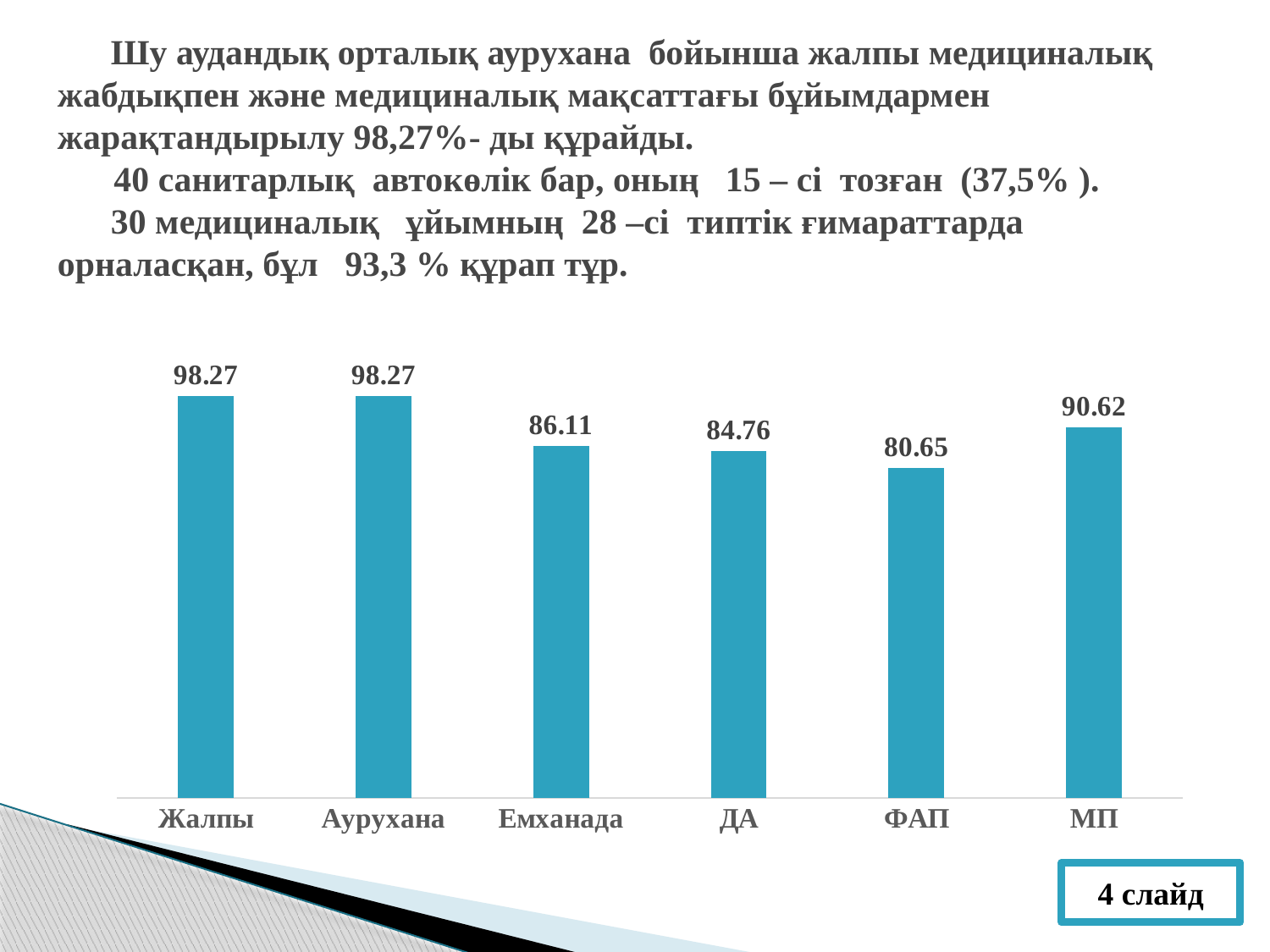
What is the difference between the values for Жалпы and ФАП? 17.62 Which category has the lowest value? ФАП Which is larger, the value for МП or the value for ФАП? МП What is the difference between the values for МП and ДА? 5.86 What is the value for ДА? 84.76 What is the value for Емханада? 86.11 What is the value for ФАП? 80.65 What kind of chart is shown on the slide? bar chart Which is larger, the value for Емханада or the value for ДА? Емханада What is the value for Аурухана? 98.27 What is the value for МП? 90.62 How many categories are shown in the chart? 6